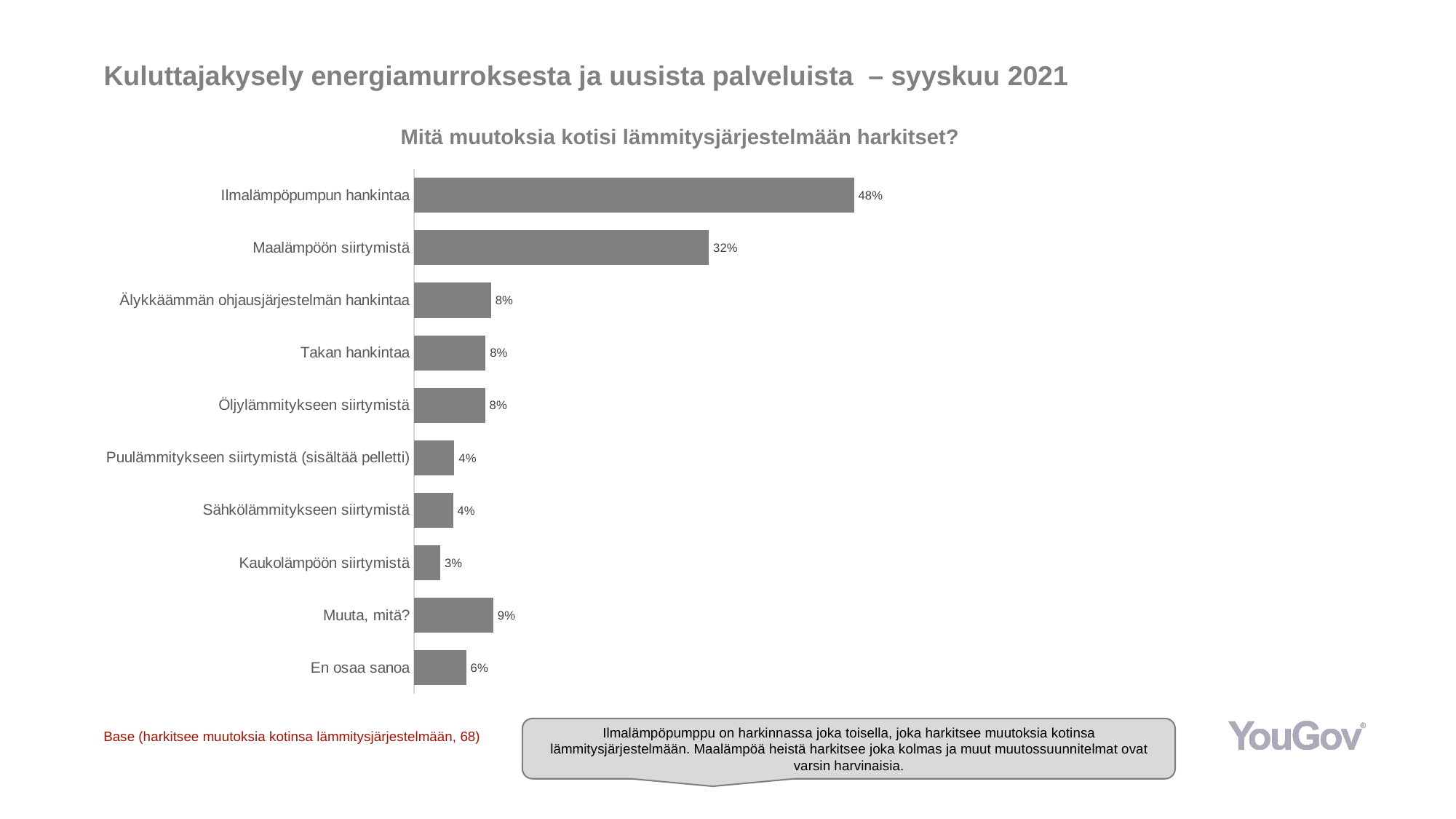
What is the value for Maalämpöön siirtymistä? 32% What is the difference between the values for Ilmalämpöpumpun hankintaa and Maalämpöön siirtymistä? 16% What is the title of the chart? Mitä muutoksia kotisi lämmitysjärjestelmään harkitset? What is the value for En osaa sanoa? 6% What is the value for Muuta, mitä?? 9% Which category has the highest value? Ilmalämpöpumpun hankintaa How many categories are shown in the chart? 10 What is the value for Ilmalämpöpumpun hankintaa? 48% What is the value for Kaukolämpöön siirtymistä? 3% What kind of chart is shown on the slide? Bar chart Which is larger, the value for Muuta, mitä? or the value for En osaa sanoa? Muuta, mitä? Which category has the lowest value? Kaukolämpöön siirtymistä